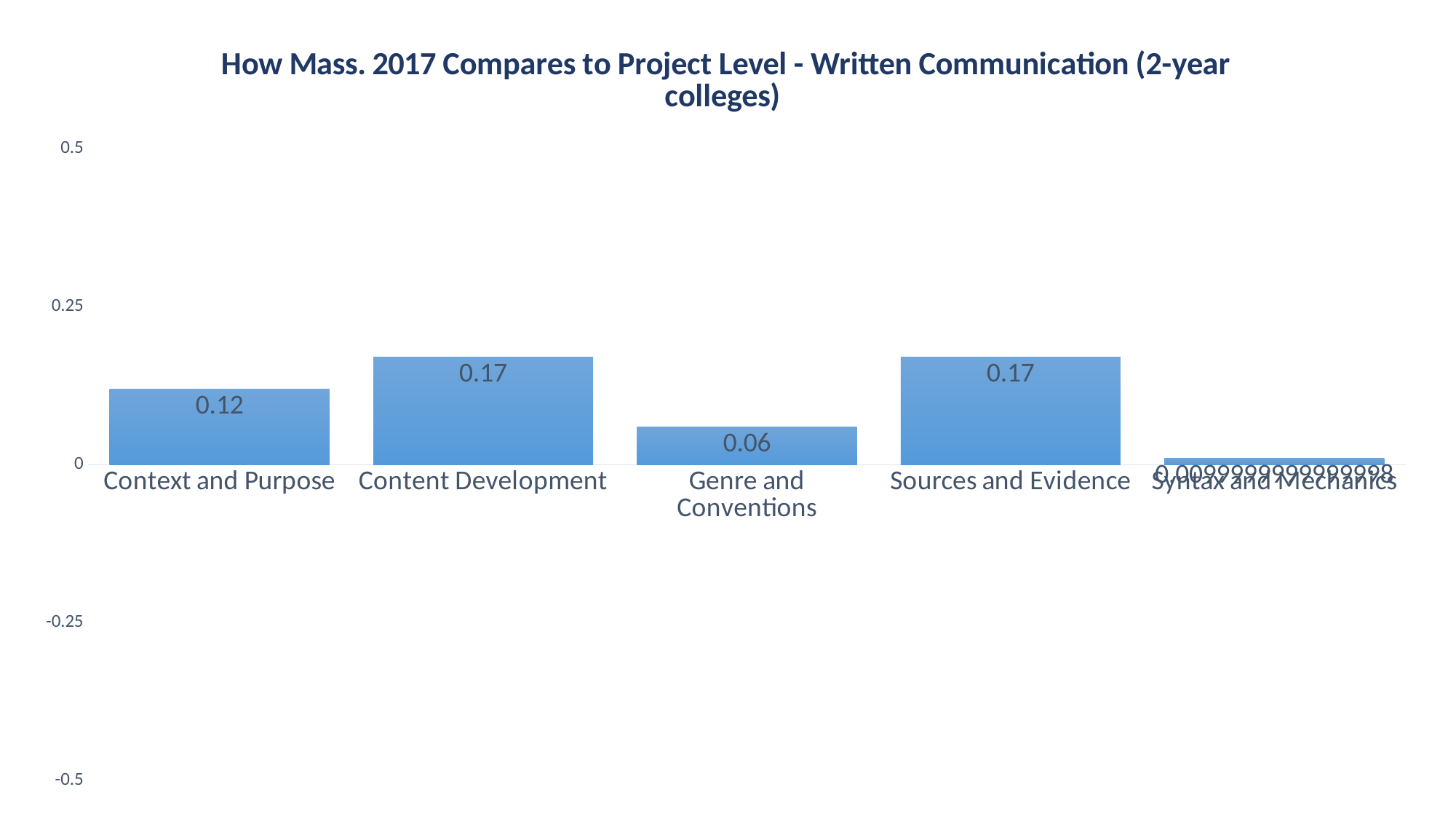
Is the value for Sources and Evidence greater or less than 0.25? less What is the title of the chart? How Mass. 2017 Compares to Project Level - Written Communication (2-year colleges) What is the value for Genre and Conventions? 0.06 What is the value for Content Development? 0.17 Which is larger, the value for Context and Purpose or the value for Genre and Conventions? Context and Purpose What is the difference between the values for Content Development and Context and Purpose? 0.05 How many categories are shown on the x axis? 5 What is the difference between the values for Context and Purpose and Genre and Conventions? 0.06 What kind of chart is shown on the slide? bar chart Which category has the lowest value? Syntax and Mechanics What is the value for Context and Purpose? 0.12 What is the value for Sources and Evidence? 0.17